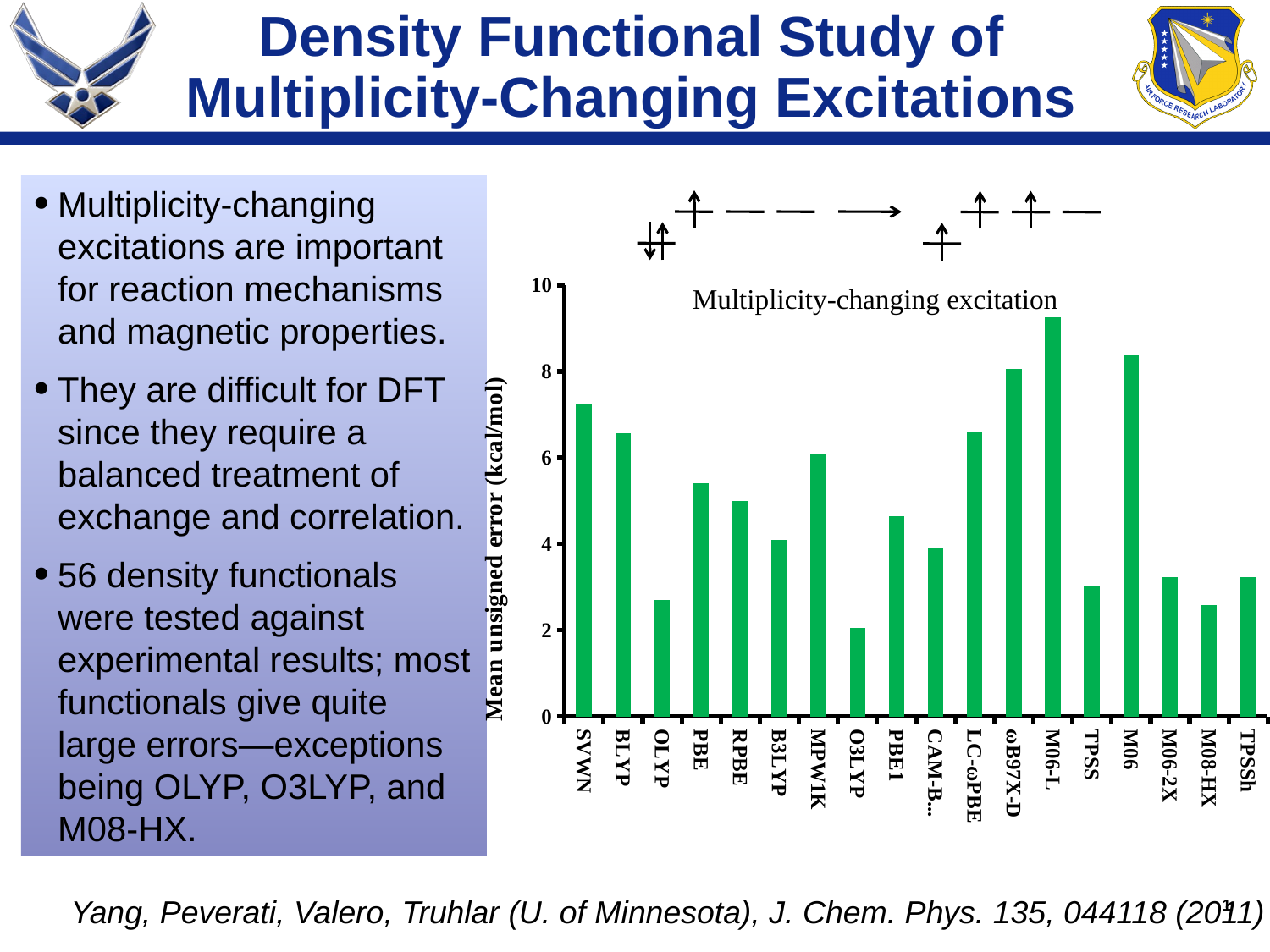
Is the mean unsigned error for PBE greater or less than 6 kcal/mol? less Is the mean unsigned error for M08-HX greater or less than 2 kcal/mol? greater Is the mean unsigned error for M06 greater or less than 8 kcal/mol? greater Which functional has the lowest mean unsigned error in the chart? O3LYP Which functional has the highest mean unsigned error in the chart? M06-L What kind of chart is shown on the slide? bar chart Which has the larger mean unsigned error, M06-L or M06? M06-L How many density functionals (categories) are plotted on the x axis of the chart? 18 What is the label on the vertical axis of the chart? Mean unsigned error (kcal/mol) Which has the larger mean unsigned error, SVWN or BLYP? SVWN